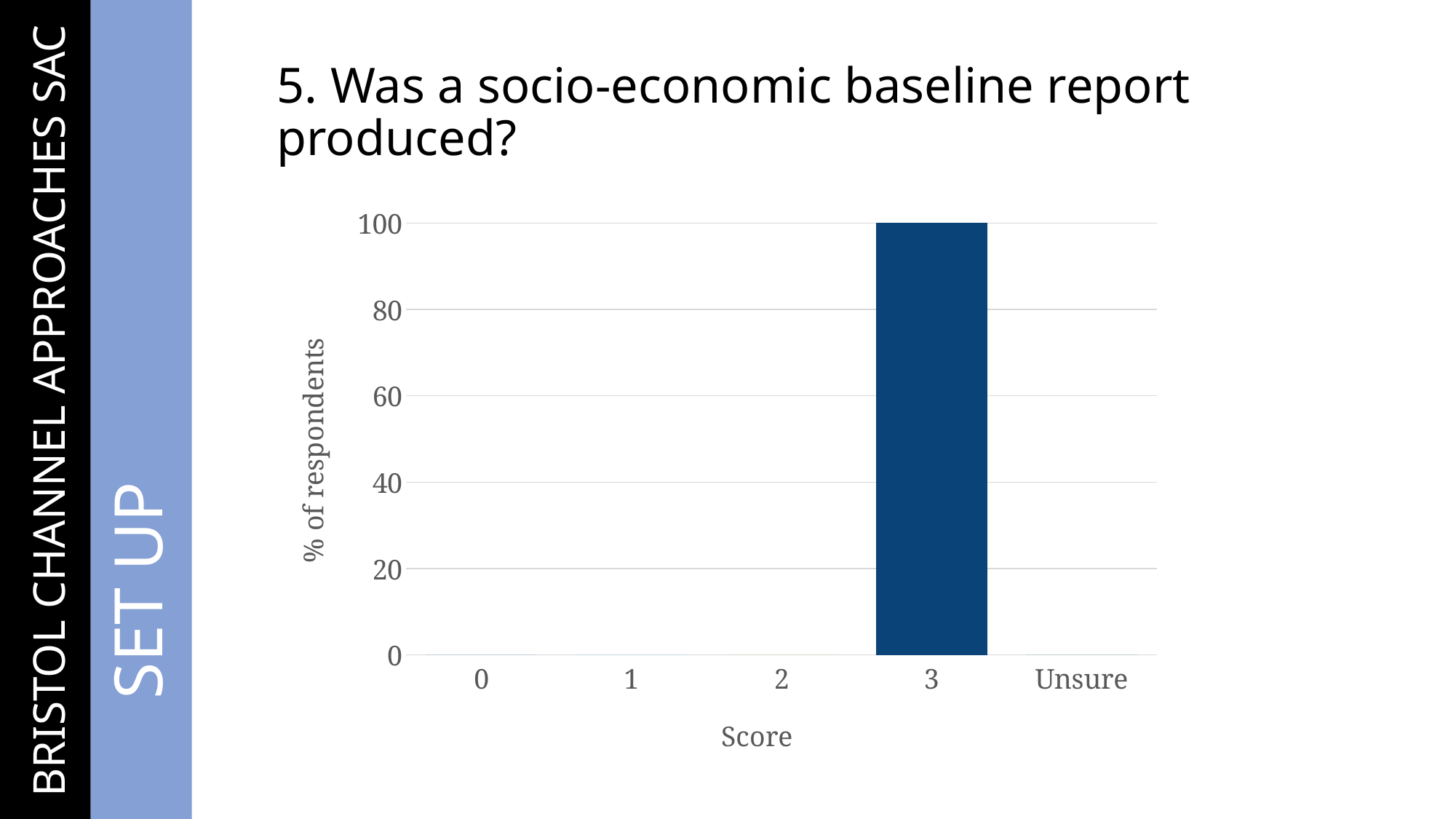
How many categories are shown on the x axis? 5 What is the difference between the value for score 3 and the value for score 2? 100 What type of chart is shown on the slide? bar chart Which score category has the highest value? 3 What is the label of the y axis? % of respondents What is the value for the Unsure category? 0 What is the label of the x axis? Score What is the value for score 0? 0 Is the value for score 2 greater or less than 20? less Is the value for score 3 greater or less than 80? greater Which is larger, the value for score 3 or the value for score 1? score 3 What is the value for score 3? 100